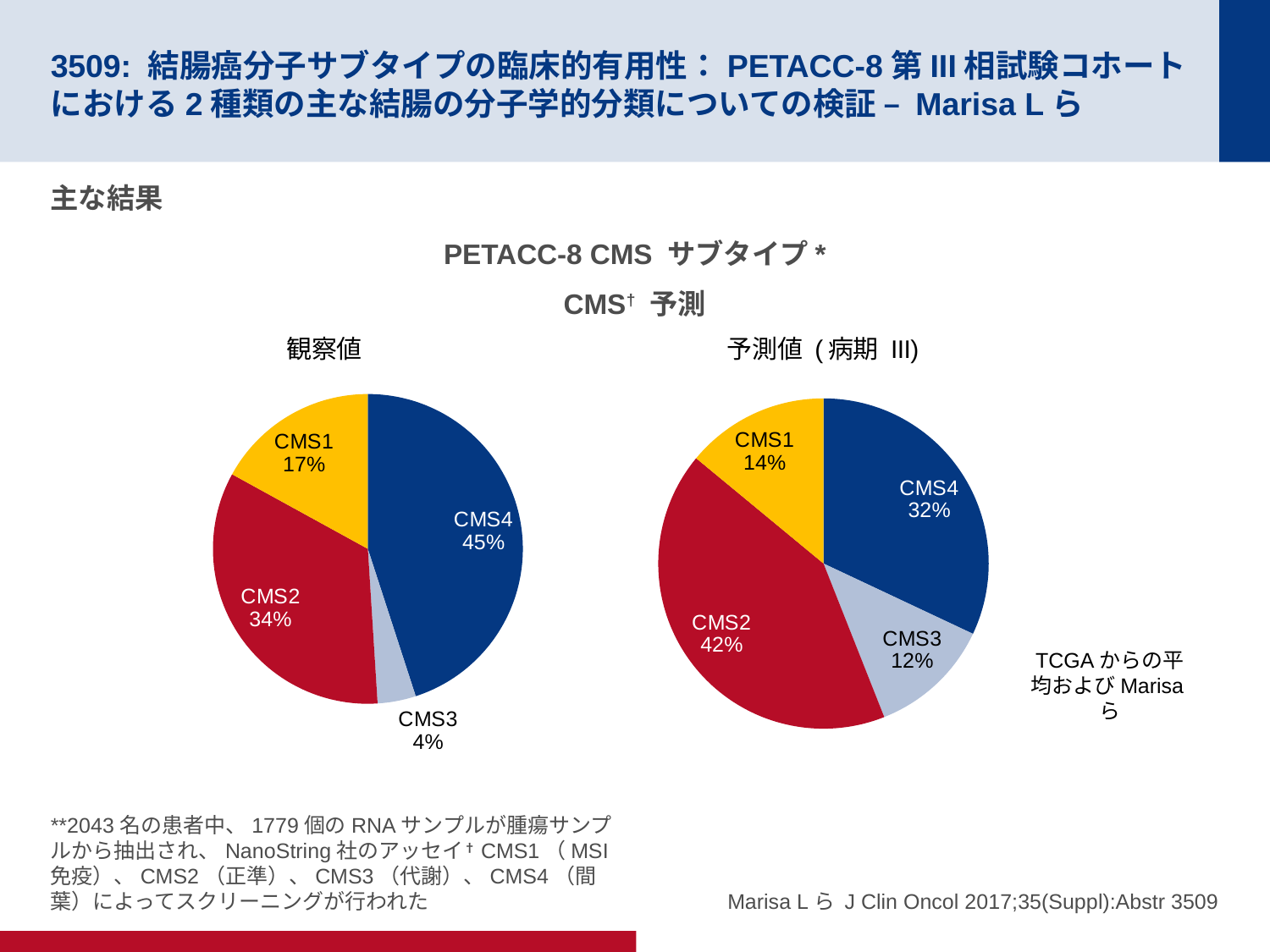
In the right pie chart titled 予測値 (病期 III), what is the share for CMS3? 12% In the left pie chart titled 観察値, what is the share for CMS4? 45% In the right pie chart titled 予測値 (病期 III), which is larger, the CMS4 share or the CMS1 share? CMS4 In the left pie chart titled 観察値, which subtype has the largest share? CMS4 How many slices does the left pie chart titled 観察値 have? 4 In the left pie chart titled 観察値, what is the share for CMS3? 4% In the left pie chart titled 観察値, what is the difference between the CMS4 share and the CMS2 share? 11% In the right pie chart titled 予測値 (病期 III), what is the share for CMS2? 42% In the left pie chart titled 観察値, what colour is the CMS1 slice? Yellow In the right pie chart titled 予測値 (病期 III), which subtype has the smallest share? CMS3 What is the difference between the CMS2 share in the right pie chart (予測値) and the CMS2 share in the left pie chart (観察値)? 8% What kind of chart is the right chart titled 予測値 (病期 III)? Pie chart